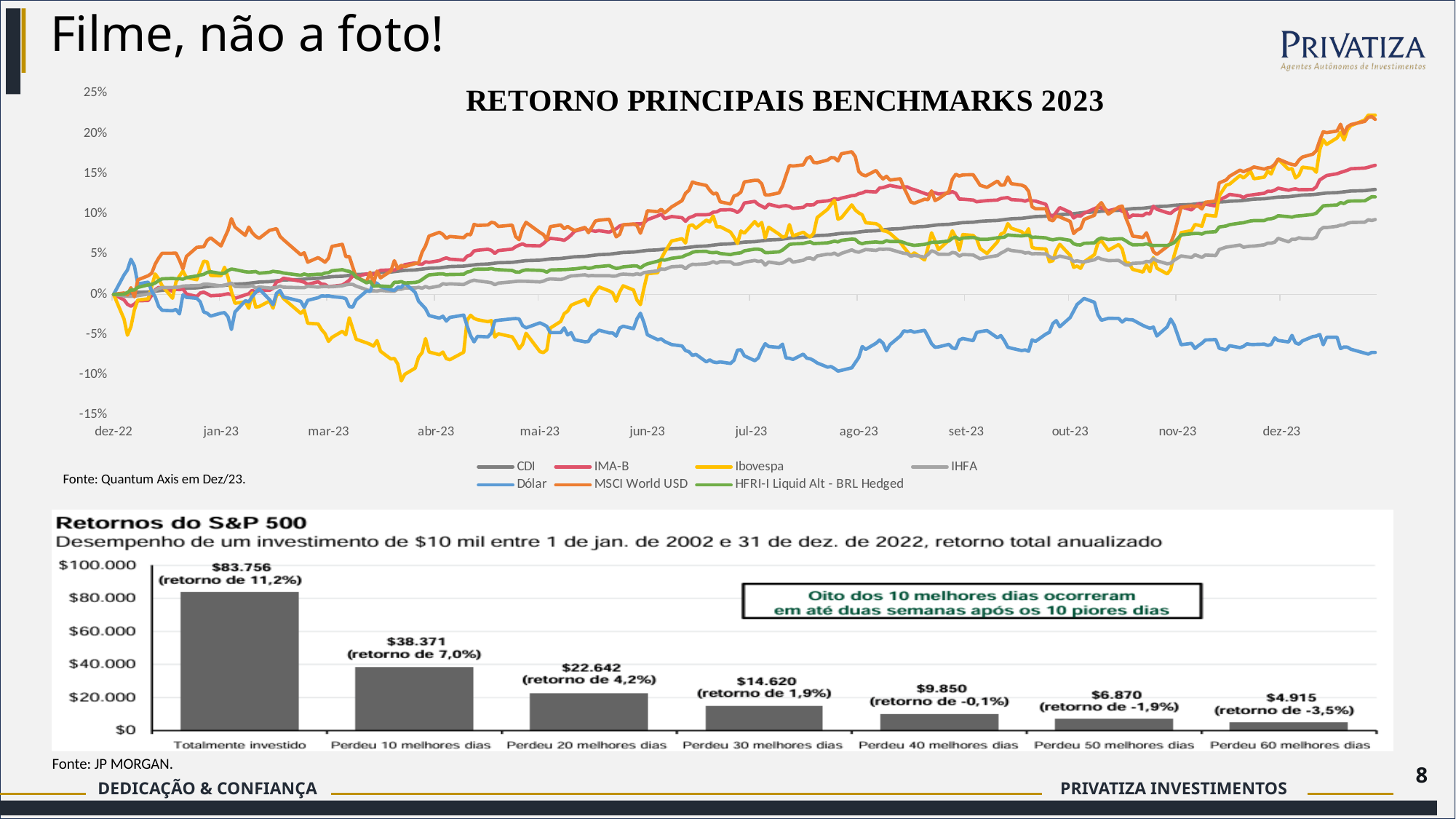
In the top chart 'RETORNO PRINCIPAIS BENCHMARKS 2023', how many series does the legend list? 7 In the bottom chart 'Retornos do S&P 500', what is the value for 'Totalmente investido'? $83.756 In the bottom chart 'Retornos do S&P 500', what is the difference between 'Totalmente investido' and 'Perdeu 10 melhores dias'? $45.385 What kind of chart is the bottom chart 'Retornos do S&P 500'? bar chart In the bottom chart 'Retornos do S&P 500', what annualized return is shown for 'Perdeu 20 melhores dias'? 4,2% In the top chart 'RETORNO PRINCIPAIS BENCHMARKS 2023', which series is the lowest at the end of dez-23? Dólar What kind of chart is the top chart titled 'RETORNO PRINCIPAIS BENCHMARKS 2023'? line chart In the top chart 'RETORNO PRINCIPAIS BENCHMARKS 2023', is the value for Dólar at the end of dez-23 greater or less than -5%? less In the bottom chart 'Retornos do S&P 500', which category has the lowest value? Perdeu 60 melhores dias In the top chart 'RETORNO PRINCIPAIS BENCHMARKS 2023', does the CDI line rise or fall over the year? rise In the top chart 'RETORNO PRINCIPAIS BENCHMARKS 2023', is the value for CDI at the end of dez-23 greater or less than 10%? greater In the bottom chart 'Retornos do S&P 500', how many bars are there? 7